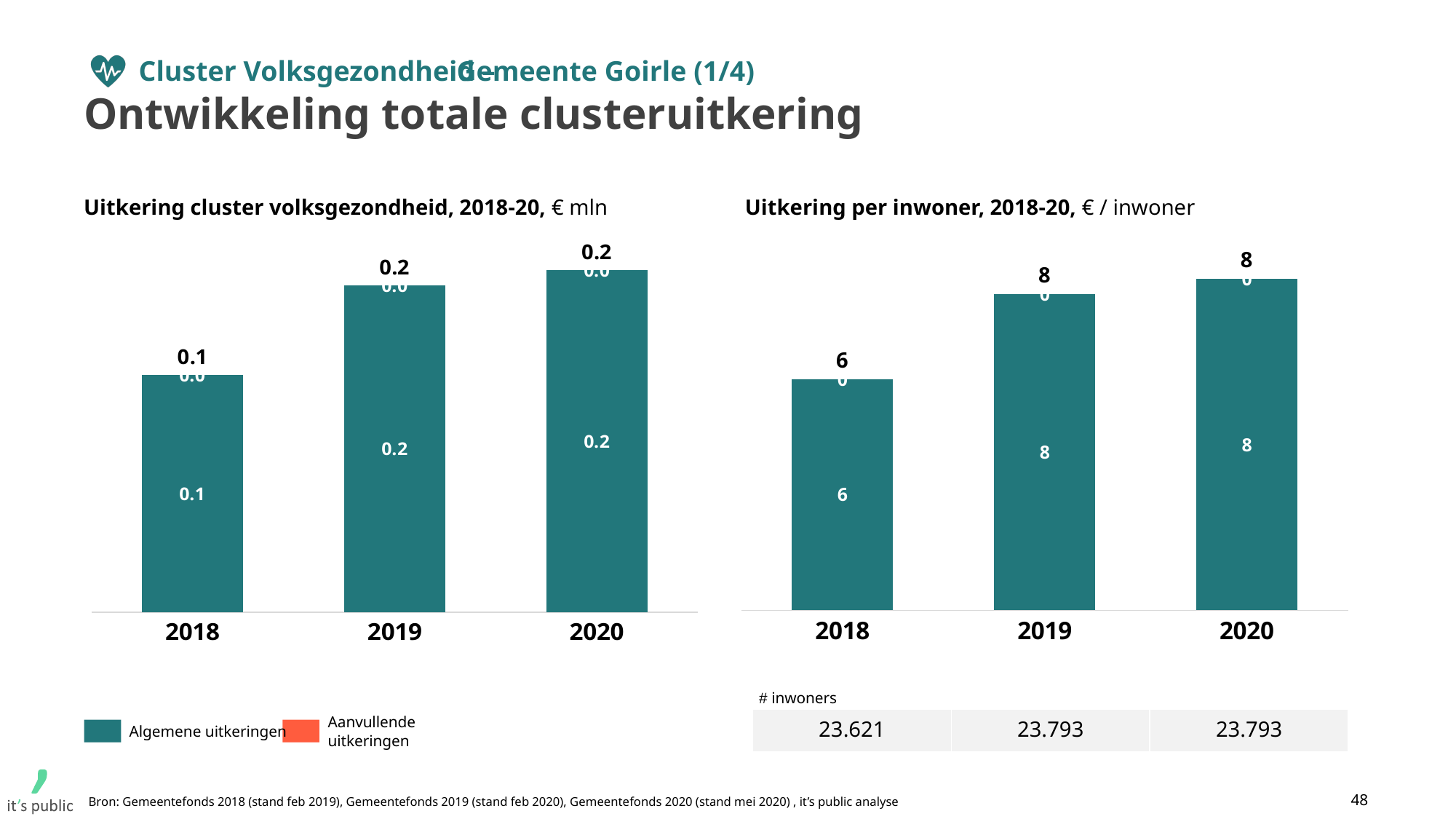
In the chart 'Uitkering cluster volksgezondheid, 2018-20', what is the total value for 2020? 0.2 In the chart 'Uitkering cluster volksgezondheid, 2018-20', which year has the lowest total? 2018 How many series does the legend on the slide list? 2 What kind of chart is 'Uitkering per inwoner, 2018-20'? bar chart In the chart 'Uitkering per inwoner, 2018-20', what is the total value for 2019? 8 In the chart 'Uitkering per inwoner, 2018-20', what is the difference between the total for 2020 and the total for 2018? 2 In the chart 'Uitkering cluster volksgezondheid, 2018-20', what is the value of Algemene uitkeringen for 2019? 0.2 In the chart 'Uitkering per inwoner, 2018-20', is the total for 2019 larger or smaller than the total for 2018? larger In the chart 'Uitkering per inwoner, 2018-20', what is the total value for 2018? 6 In the chart 'Uitkering cluster volksgezondheid, 2018-20', what is the total value for 2018? 0.1 How many years are shown on the x axis of the chart 'Uitkering cluster volksgezondheid, 2018-20'? 3 In the chart 'Uitkering per inwoner, 2018-20', which year has the lowest total? 2018